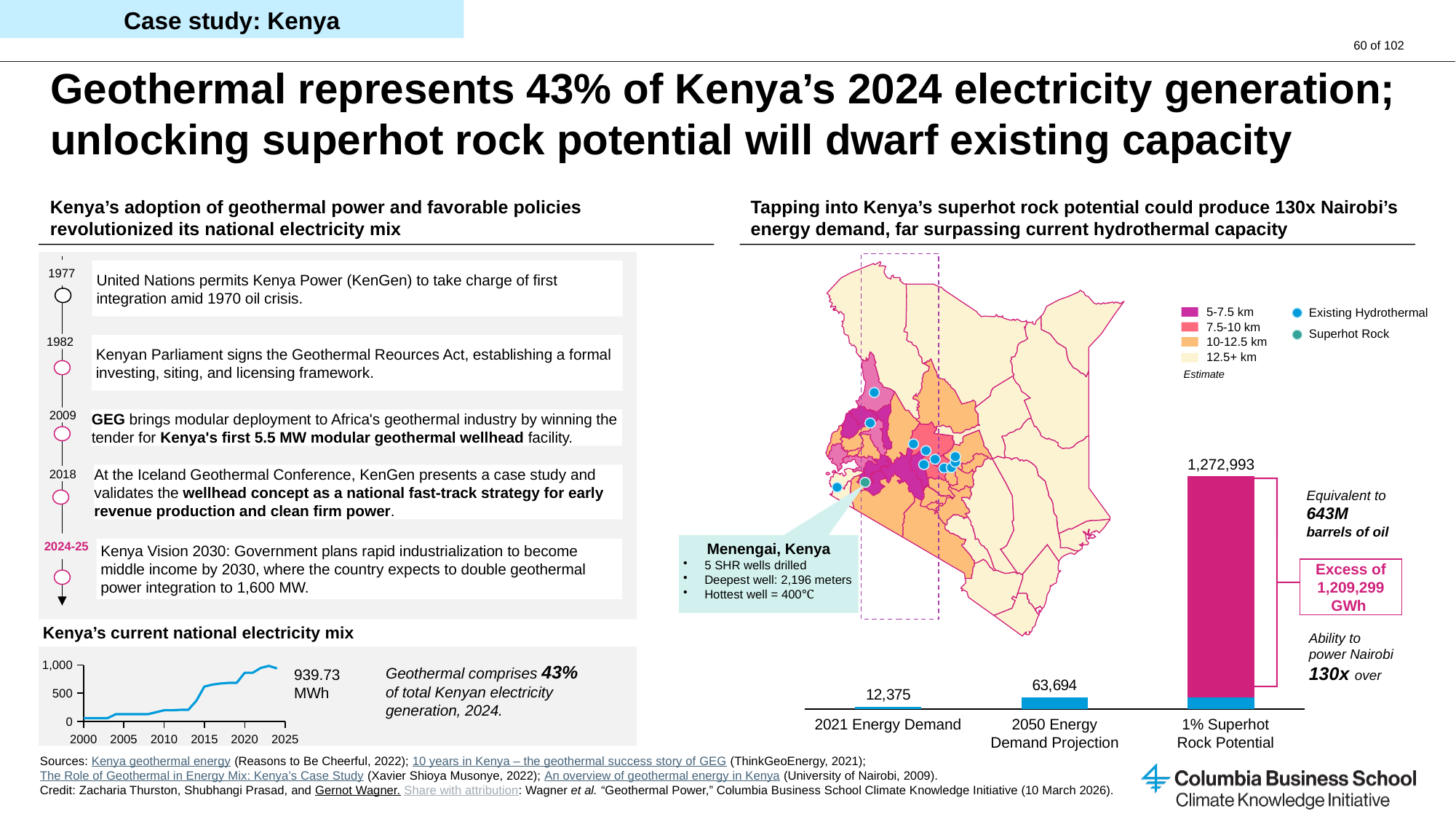
In the bar chart on the right, which category has the highest value? 1% Superhot Rock Potential In the bar chart on the right, what is the value for 2050 Energy Demand Projection? 63,694 What kind of chart is the 'Kenya's current national electricity mix' chart? Line chart How many categories are shown in the bar chart on the right? 3 In the bar chart on the right, what is the difference between the 2050 Energy Demand Projection and the 2021 Energy Demand? 51,319 In the bar chart on the right, which category has the lowest value? 2021 Energy Demand In the bar chart on the right, what is the value for 2021 Energy Demand? 12,375 In the 'Kenya's current national electricity mix' chart, is the value in 2010 greater or less than 500? less In the bar chart on the right, which is larger: 2050 Energy Demand Projection or 2021 Energy Demand? 2050 Energy Demand Projection In the bar chart on the right, what is the value for 1% Superhot Rock Potential? 1,272,993 In the 'Kenya's current national electricity mix' chart, do the values rise or fall from 2000 to 2025? Rise In the 'Kenya's current national electricity mix' chart, what is the labeled value at the end of the line? 939.73 MWh